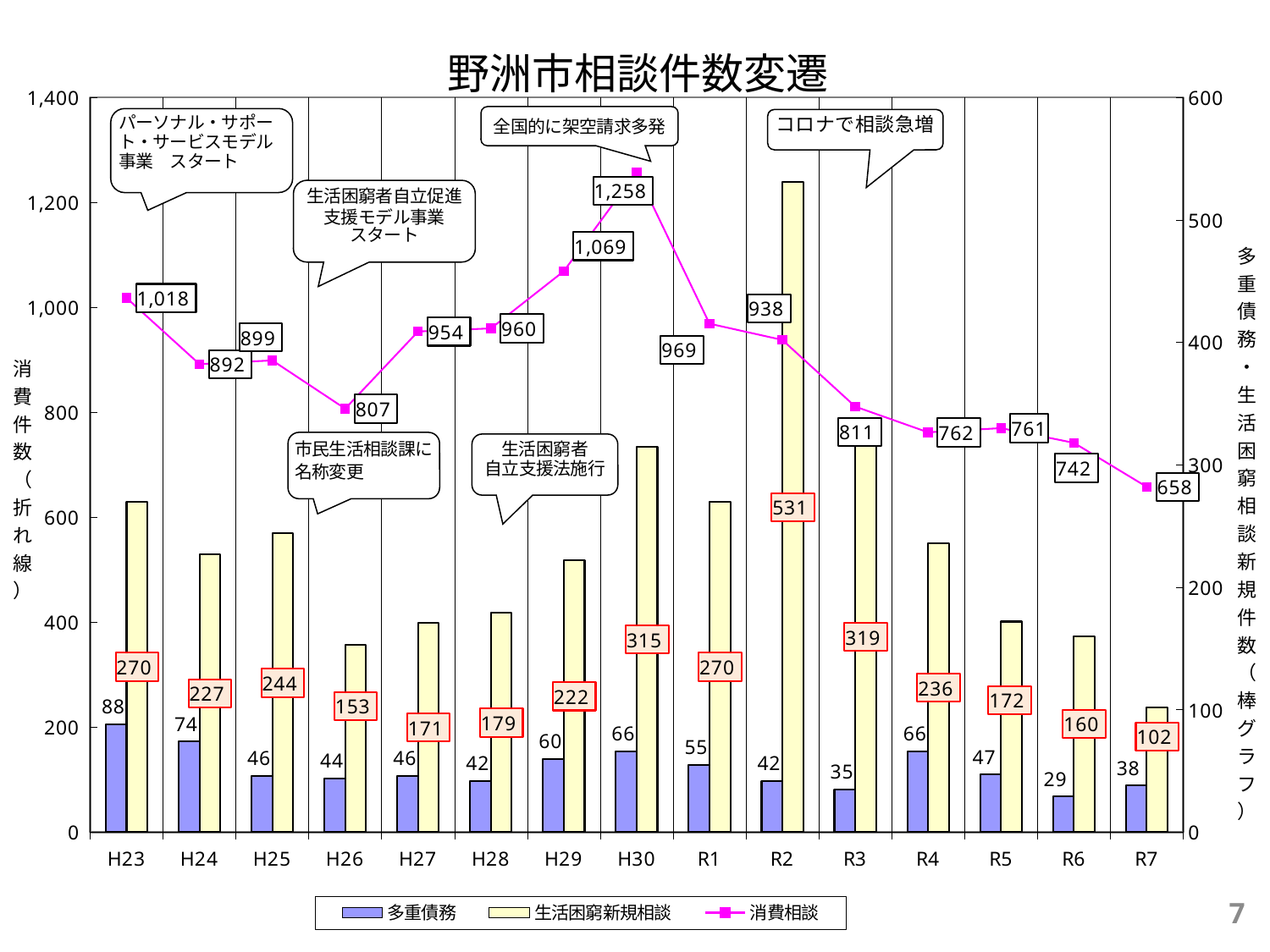
What is the difference between the 消費相談 values for H30 and R7? 600 Which year has the highest value for 消費相談? H30 What is the title of the chart? 野洲市相談件数変遷 Which year has the lowest value for 多重債務? R6 Which year has the lowest value for 生活困窮新規相談? R7 How many years are shown on the x axis? 15 What is the value of 消費相談 for H30? 1,258 What is the value of 多重債務 for H23? 88 Which is larger, the 生活困窮新規相談 value for H30 or for R3? R3 How many series does the legend list? 3 What is the value of 生活困窮新規相談 for R2? 531 Does the 消費相談 line rise or fall from H30 to R7? fall